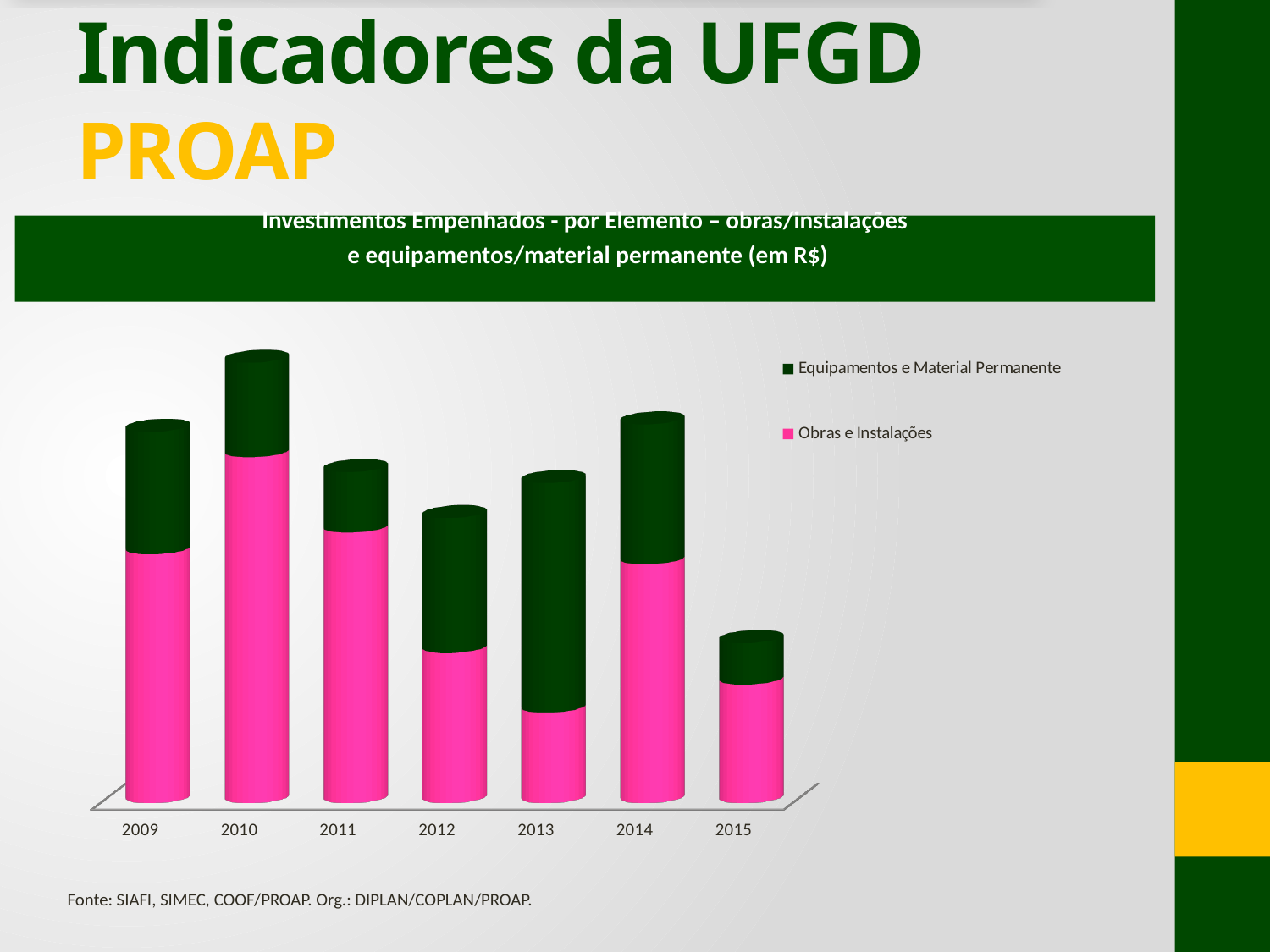
Which year has the tallest total bar in the chart? 2010 Which year has the smallest Obras e Instalações segment? 2013 Which year has the largest Equipamentos e Material Permanente segment? 2013 What kind of chart is shown on the slide? Stacked bar chart How many years are shown on the x axis of the chart? 7 How many series does the chart legend list? 2 Which year has the shortest total bar in the chart? 2015 Which year has the largest Obras e Instalações segment? 2010 Which series is shown in pink in the chart? Obras e Instalações Which year has the taller total bar, 2009 or 2011? 2009 Which series is shown in dark green in the chart? Equipamentos e Material Permanente Which year has the taller total bar, 2012 or 2014? 2014